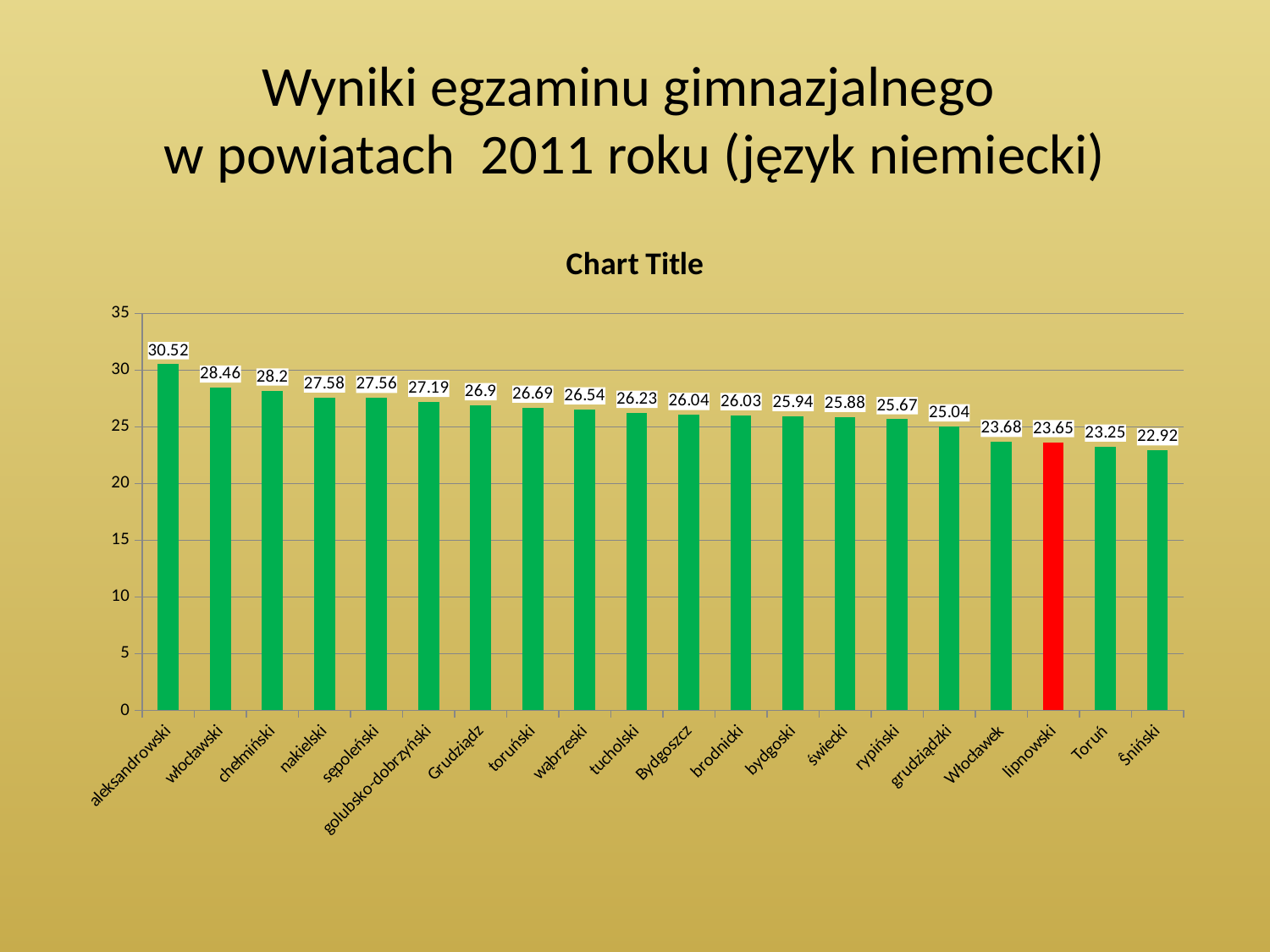
What is the value for Grudziądz? 26.9 Which category has the highest value? aleksandrowski How many categories are shown on the x axis? 20 What is the value for aleksandrowski? 30.52 Is the value for Toruń greater or less than 25? less What kind of chart is shown on the slide? bar chart Which category has the lowest value? Ŝniński What is the difference between the values for aleksandrowski and żniński? 7.6 What is the value for lipnowski? 23.65 Which category's bar is coloured red? lipnowski What is the value for grudziądzki? 25.04 Which is larger, the value for włocławski or the value for Włocławek? włocławski